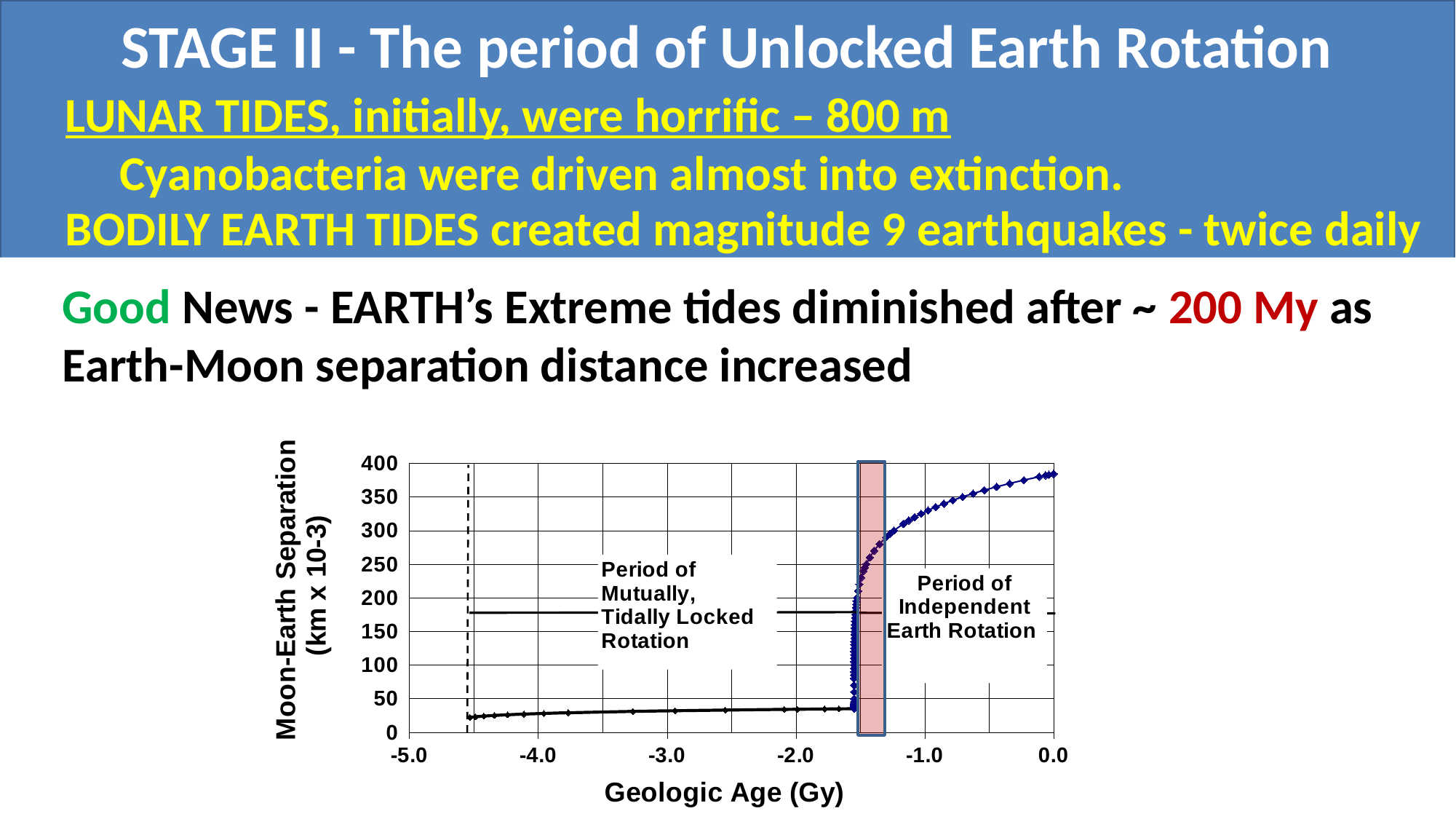
What is the title of the y axis of the chart? Moon-Earth Separation (km x 10-3) Is the Moon-Earth separation larger at 0.0 Gy or at -4.0 Gy? 0.0 Gy Does the Moon-Earth separation rise or fall as geologic age moves from -5.0 toward 0.0 Gy? rise How many labelled tick marks are on the x axis of the chart? 6 Is the Moon-Earth separation at -4.0 Gy greater or less than 50? less Is the Moon-Earth separation larger at -3.0 Gy or at -1.0 Gy? -1.0 Gy What is the maximum value shown on the y axis of the chart? 400 Is the Moon-Earth separation at 0.0 Gy greater or less than 350? greater What kind of chart is shown on the slide? line chart Is the Moon-Earth separation at -2.0 Gy greater or less than 100? less What is the title of the x axis of the chart? Geologic Age (Gy)